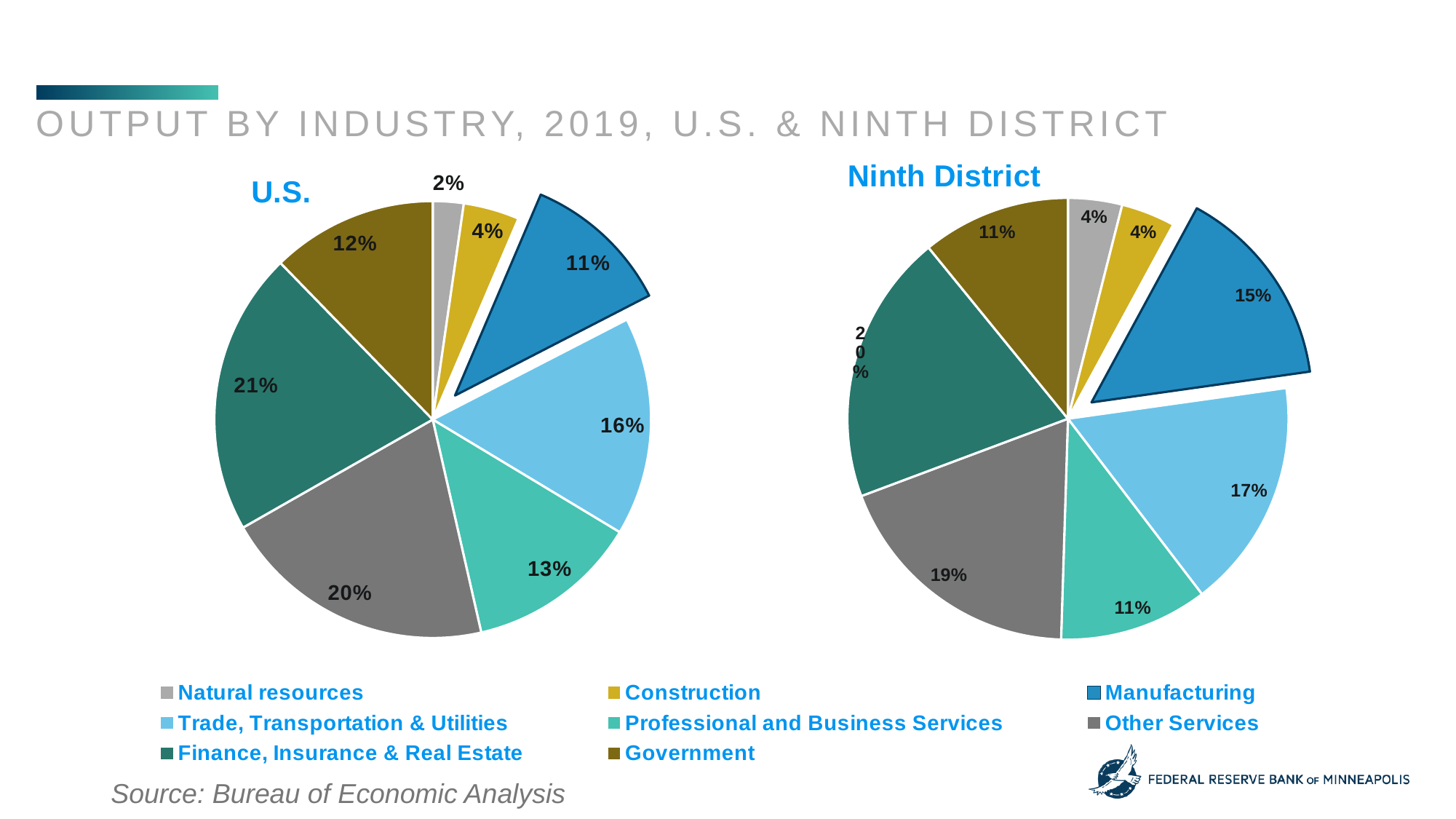
In the Ninth District pie chart, what share of output is Other Services? 19% In the Ninth District pie chart, what share of output is Manufacturing? 15% In the Ninth District pie chart, which industry has the largest share? Finance, Insurance & Real Estate In the U.S. pie chart, which industry has the largest share? Finance, Insurance & Real Estate What type of chart is used for the U.S. and Ninth District data? Pie chart In the U.S. pie chart, what share of output is Finance, Insurance & Real Estate? 21% In the U.S. pie chart, which industry has the smallest share? Natural resources In the U.S. pie chart, what share of output is Manufacturing? 11% How many percentage points higher is the Manufacturing share in the Ninth District pie chart than in the U.S. pie chart? 4 How many industry categories does the legend list? 8 In the Ninth District pie chart, what is the combined share of Natural resources and Construction? 8% In the U.S. pie chart, which is larger: Trade, Transportation & Utilities or Professional and Business Services? Trade, Transportation & Utilities